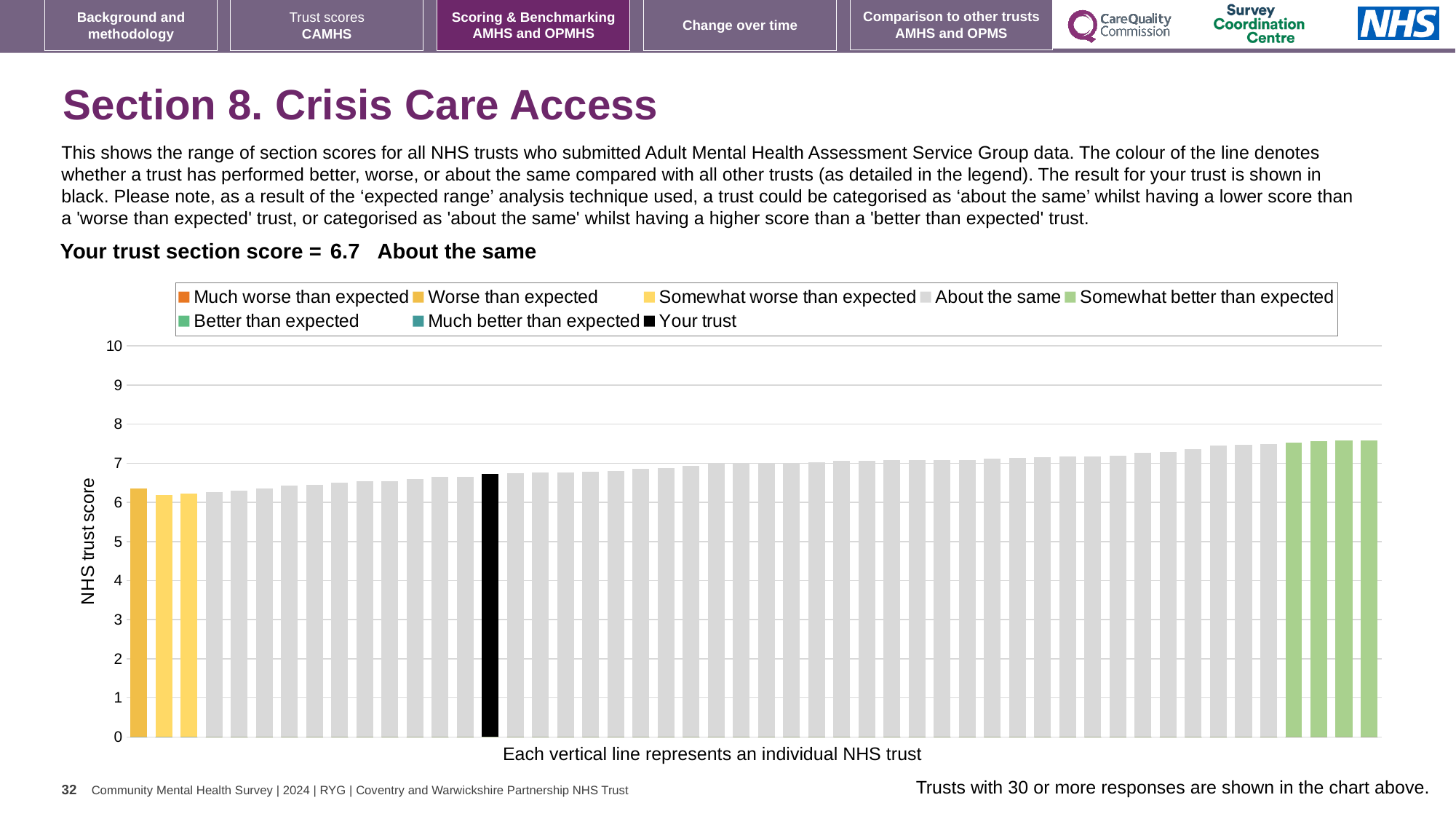
Is the value of the tallest bar greater or less than 7? greater Is the value of the tallest bar greater or less than 8? less Is the value of the shortest bar greater or less than 6? greater Which legend category do the highest-scoring trusts on the right of the chart belong to? Somewhat better than expected Do the bar values rise or fall from left to right along the x axis? Rise What colour is the bar representing your trust? Black What kind of chart is shown on the slide? Bar chart How many entries does the chart legend list? 8 Which category is your trust's section score placed in? About the same What is the label on the vertical axis of the chart? NHS trust score What is the section score for your trust shown on the slide? 6.7